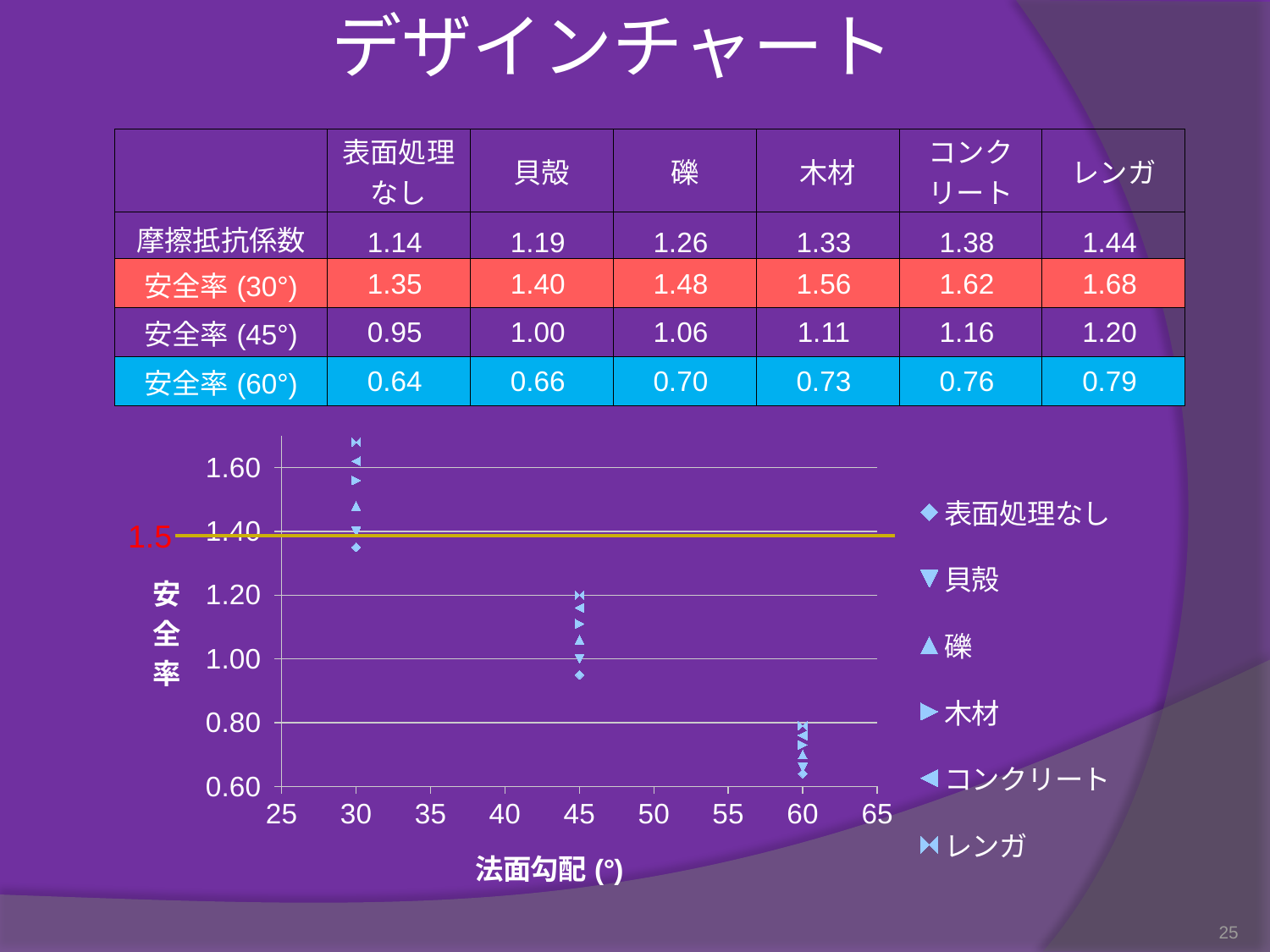
What is the difference between the 安全率 of レンガ and 表面処理なし at a slope of 30°? 0.33 According to the slide, what is the 安全率 for 貝殻 at a slope of 60°? 0.66 Which material has the highest 安全率 at a slope of 30°? レンガ What is the label of the x axis of the chart? 法面勾配 (°) In the chart, is the 安全率 for レンガ at 30° greater or less than 1.60? greater How many series does the chart legend list? 6 According to the slide, what is the 安全率 for コンクリート at a slope of 30°? 1.62 Which material has the lowest 安全率 at a slope of 60°? 表面処理なし At a slope of 45°, which has the larger 安全率, 木材 or 貝殻? 木材 What kind of chart is shown on the slide? scatter chart Which series in the chart legend is marked with an upward-pointing triangle? 礫 At how many slope angles (法面勾配) are points plotted for each series in the chart? 3